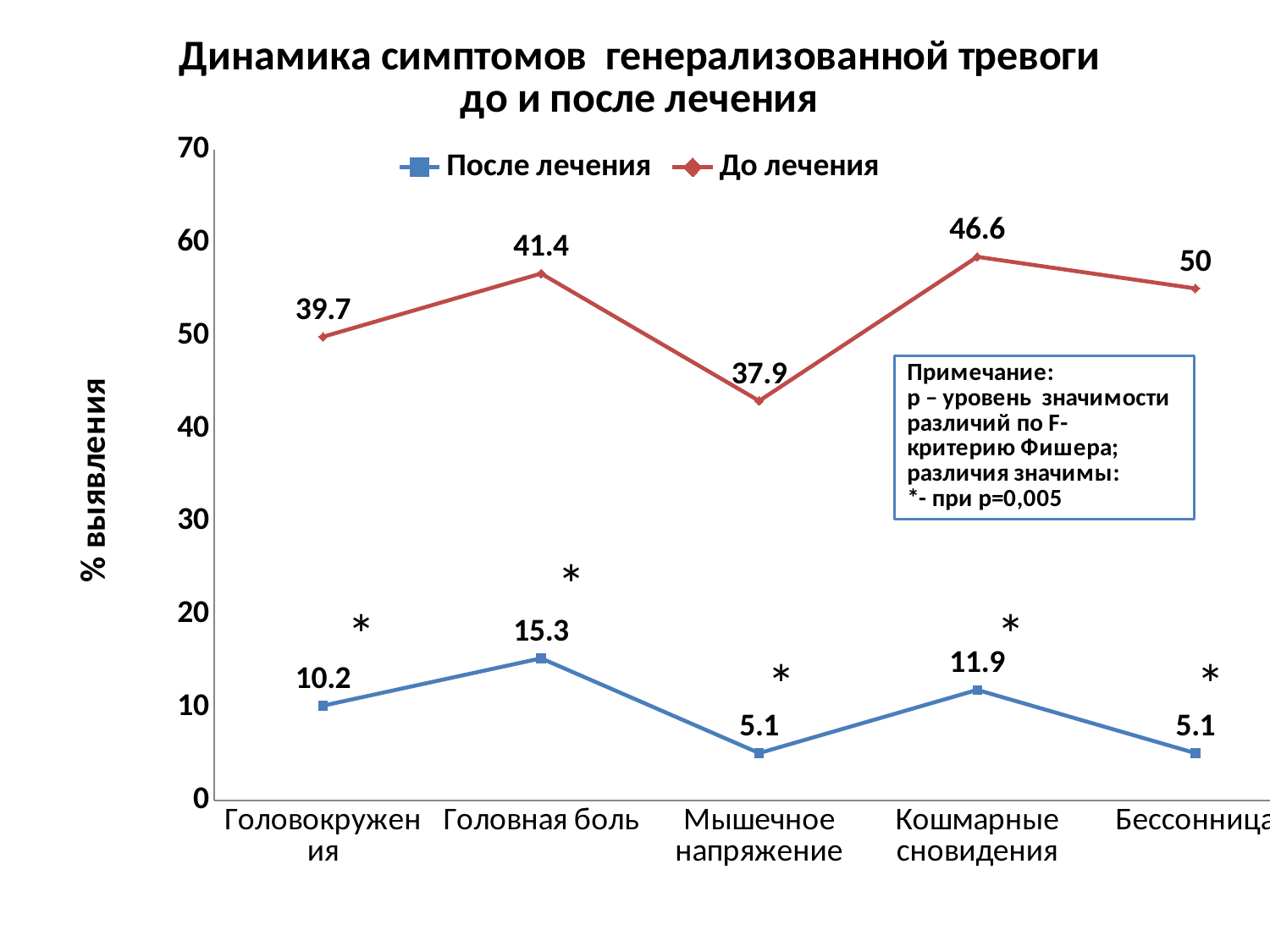
Which category has the highest value in the После лечения series? Головная боль Which category has the lowest value in the До лечения series? Мышечное напряжение What is the value for Головная боль in the До лечения series? 41.4 What is the value for Кошмарные сновидения in the После лечения series? 11.9 Which category has the highest value in the До лечения series? Бессонница Which is larger: the После лечения value for Головокружения or for Мышечное напряжение? Головокружения What is the difference between the До лечения and После лечения values for Кошмарные сновидения? 34.7 How many series does the legend list? 2 What kind of chart is shown on the slide? Line chart How many categories are shown on the x axis? 5 What is the label of the y axis? % выявления What is the value for Бессонница in the До лечения series? 50